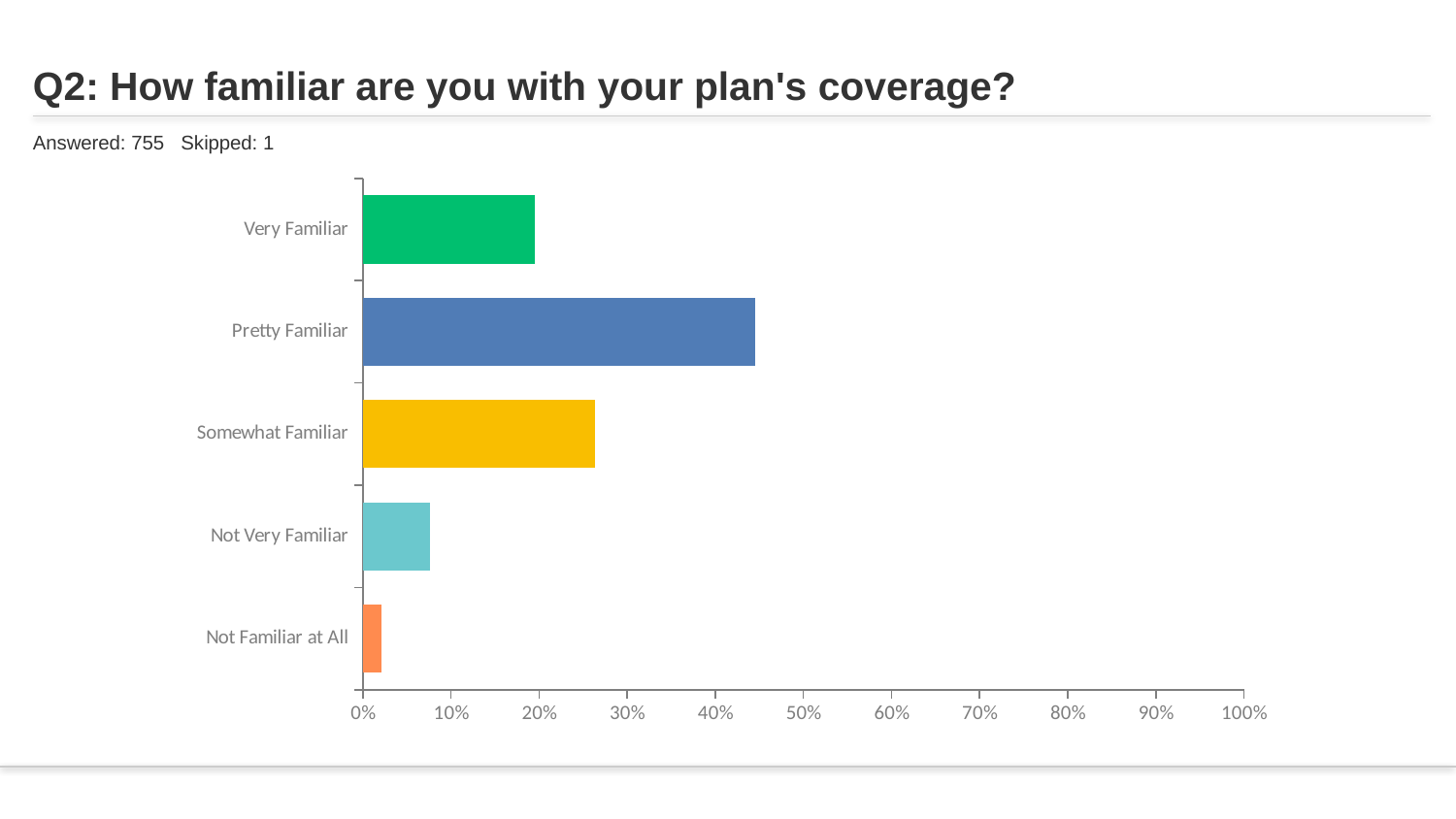
Is the value for Pretty Familiar greater or less than 40%? greater Which category has the lowest value? Not Familiar at All Is the value for Not Very Familiar greater or less than 10%? less What kind of chart is shown on the slide? bar chart How many respondents answered the question according to the slide? 755 What is the title of the chart? Q2: How familiar are you with your plan's coverage? Is the value for Somewhat Familiar greater or less than 30%? less Which is larger, the value for Not Very Familiar or the value for Not Familiar at All? Not Very Familiar Which is larger, the value for Somewhat Familiar or the value for Very Familiar? Somewhat Familiar Which category has the highest value? Pretty Familiar How many categories does the chart show? 5